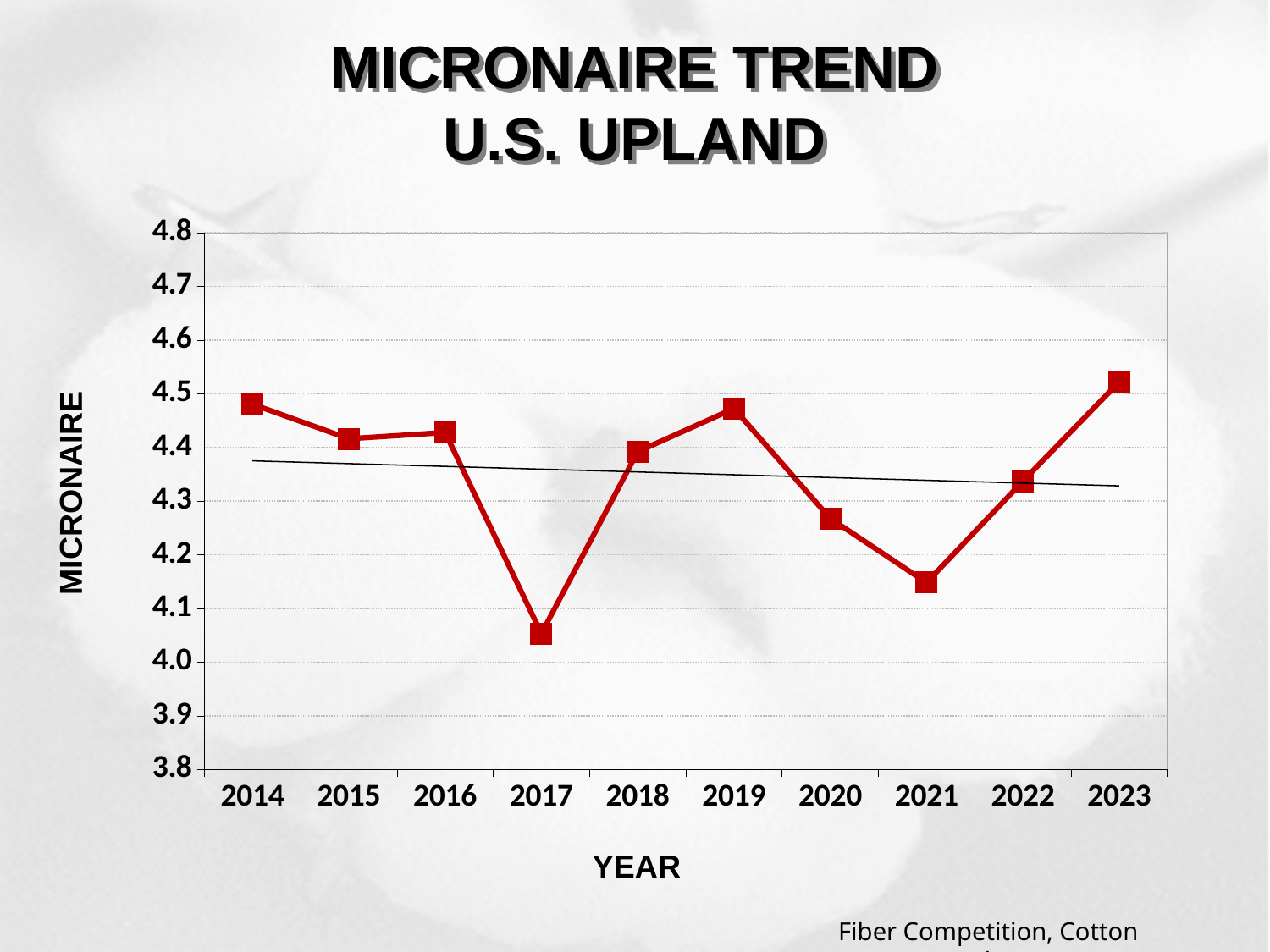
How many years are plotted on the x axis? 10 What is the title of the chart? MICRONAIRE TREND U.S. UPLAND Which year has the highest micronaire value? 2023 Which year has the lowest micronaire value? 2017 Do the micronaire values rise or fall from 2019 to 2021? fall Is the micronaire value for 2023 greater or less than 4.5? greater Which year has the larger micronaire value, 2018 or 2020? 2018 Is the micronaire value for 2021 greater or less than 4.2? less What is the label on the y axis? MICRONAIRE What kind of chart is shown on the slide? line chart Is the micronaire value for 2017 greater or less than 4.1? less